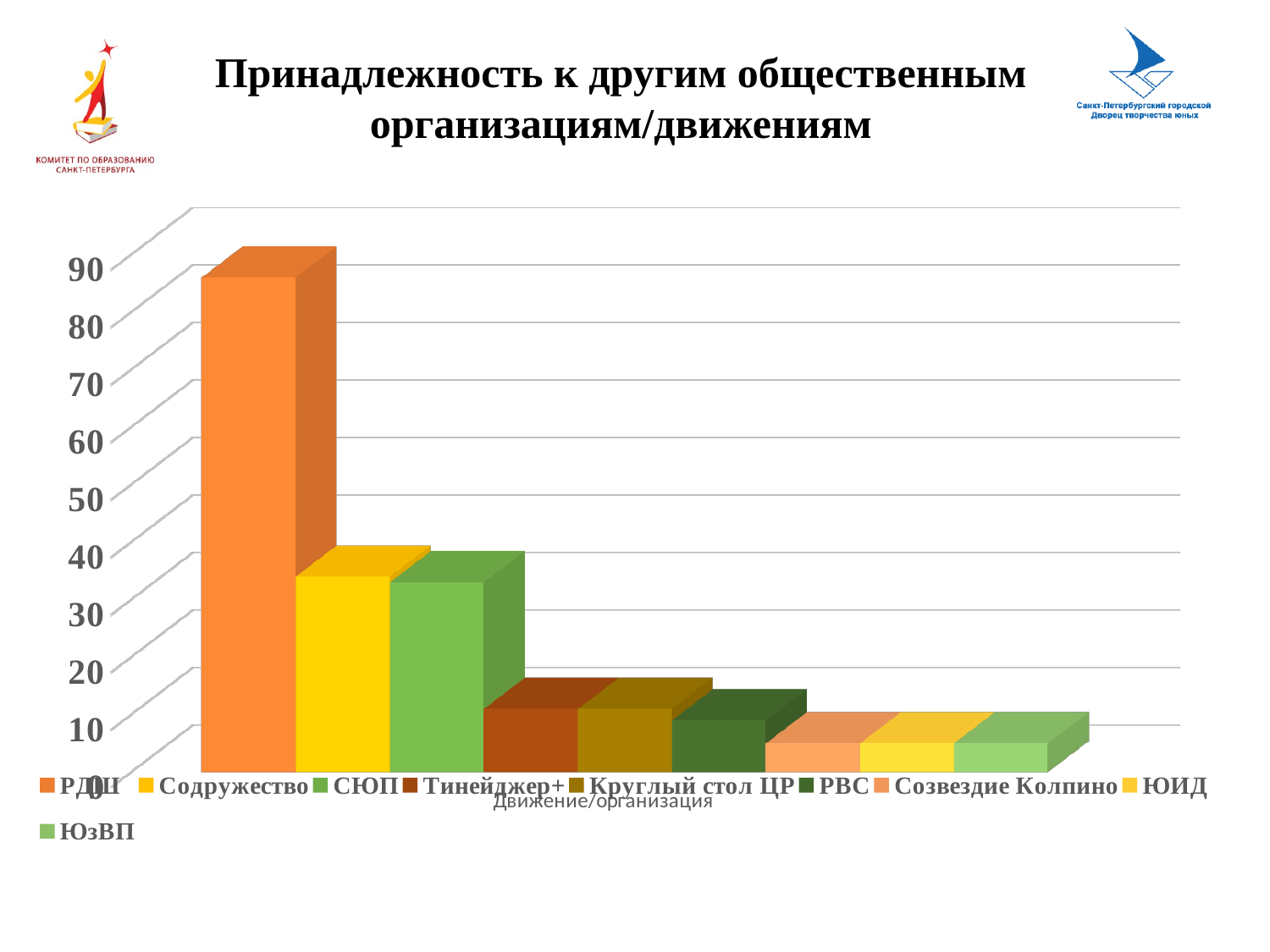
What is the title of the chart? Принадлежность к другим общественным организациям/движениям Is the value for РДШ greater or less than 80? greater Is the value for Содружество greater or less than 30? greater How many bars are plotted in the chart? 9 How many series does the legend list? 9 Which is larger, the value for РДШ or the value for Содружество? РДШ Is the value for Тинейджер+ greater or less than 20? less Do the bar values generally rise or fall from left to right? fall Which is larger, the value for Содружество or the value for РВС? Содружество What kind of chart is shown on the slide? bar chart Which organisation has the highest bar? РДШ